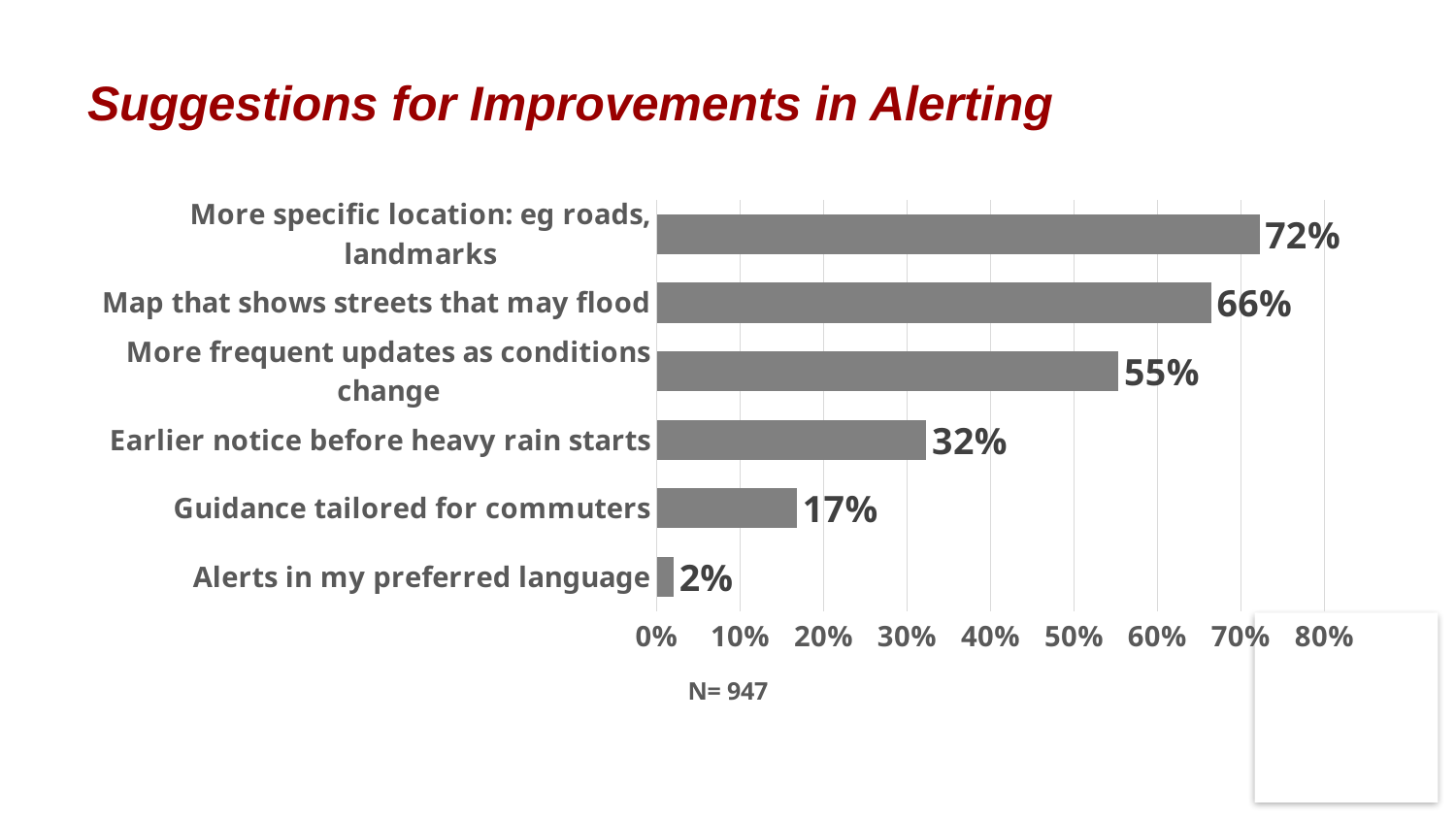
How many suggestions are shown in the chart? 6 What is the value for 'Earlier notice before heavy rain starts'? 32% What percentage of respondents suggested a map that shows streets that may flood? 66% What is the difference between 'More frequent updates as conditions change' and 'Earlier notice before heavy rain starts'? 23% Which suggestion has the highest percentage? More specific location: eg roads, landmarks Is the value for 'More frequent updates as conditions change' greater or less than 50%? greater Which suggestion has the lowest percentage? Alerts in my preferred language What is the difference between 'More specific location: eg roads, landmarks' and 'Map that shows streets that may flood'? 6% What is the sample size (N) noted below the chart? 947 What is the value for 'Guidance tailored for commuters'? 17% Which is larger: 'Guidance tailored for commuters' or 'Earlier notice before heavy rain starts'? Earlier notice before heavy rain starts What kind of chart is shown on the slide? Bar chart